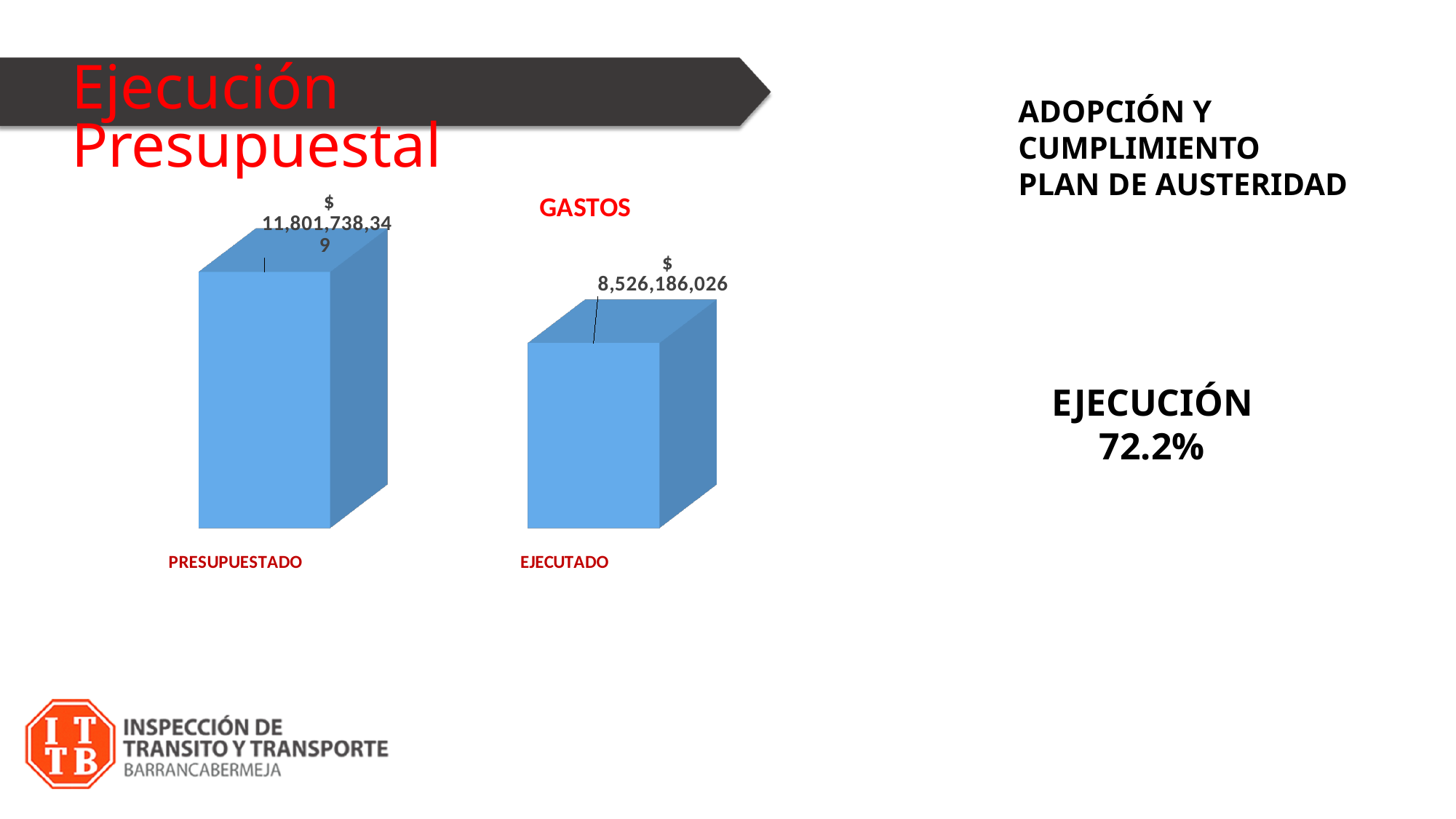
What kind of chart is the GASTOS chart? bar chart What is the value of the PRESUPUESTADO bar in the GASTOS chart? $ 11,801,738,349 Which category has the highest value in the GASTOS chart? PRESUPUESTADO What is the title of the chart on the slide? GASTOS In the GASTOS chart, is the value for PRESUPUESTADO larger or smaller than the value for EJECUTADO? larger Which category has the lowest value in the GASTOS chart? EJECUTADO What is the value of the EJECUTADO bar in the GASTOS chart? $ 8,526,186,026 What is the difference between the PRESUPUESTADO and EJECUTADO values in the GASTOS chart? $ 3,275,552,323 How many categories are shown in the GASTOS chart? 2 What colour are the bars in the GASTOS chart? blue Do the values in the GASTOS chart rise or fall from PRESUPUESTADO to EJECUTADO? fall